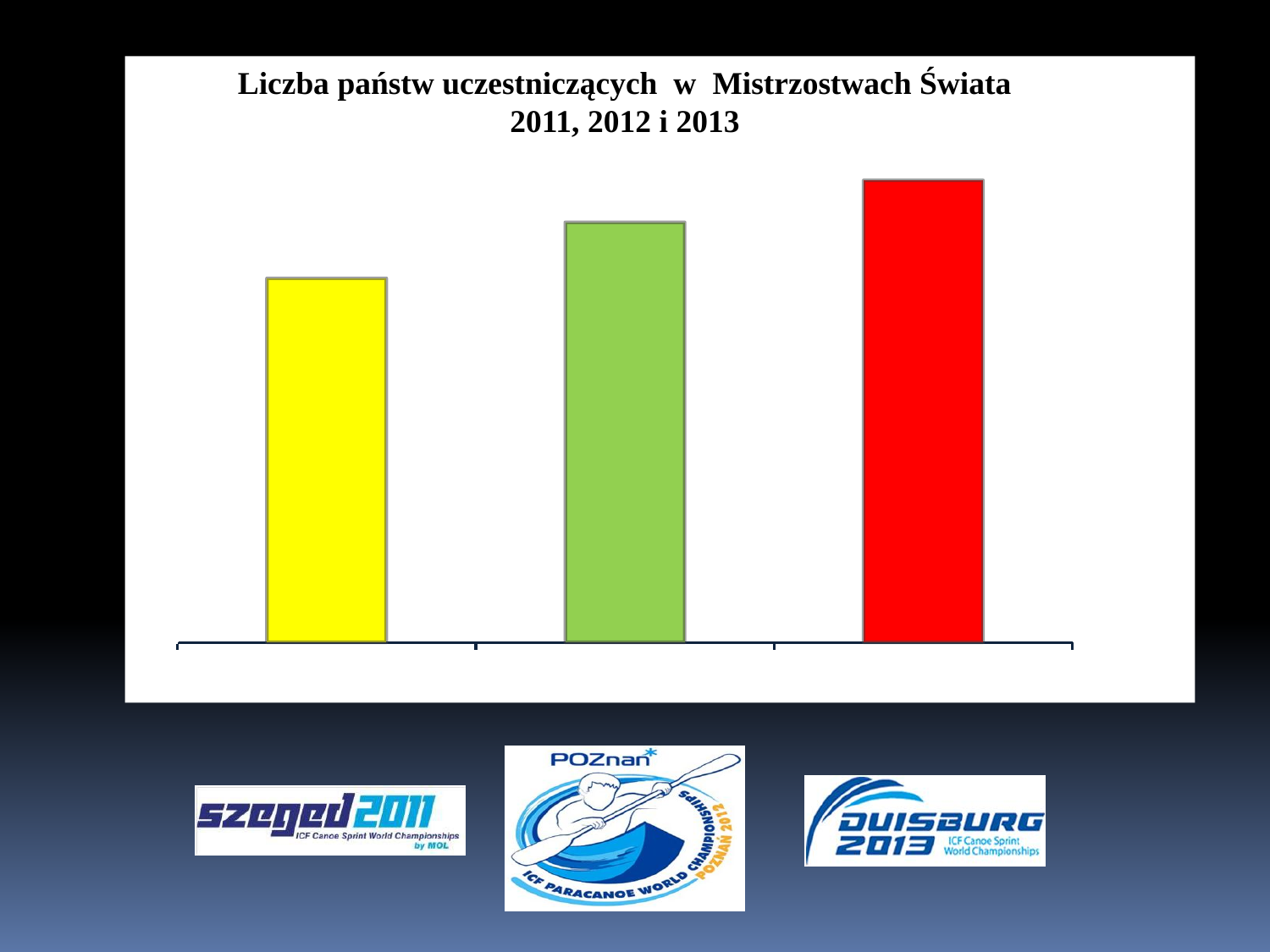
Which position does the tallest bar occupy in the chart: left, middle or right? right What colour is the middle bar in the chart? green Which bar is taller, the red bar or the green bar? red Which bar is taller, the green bar or the yellow bar? green What kind of chart is shown on the slide? bar chart Which bar is the tallest in the chart: the yellow, the green or the red one? red How many bars does the chart contain? 3 Which bar is the shortest in the chart: the yellow, the green or the red one? yellow Do the bar heights rise or fall from left to right across the chart? rise What is the title of the chart? Liczba państw uczestniczących w Mistrzostwach Świata 2011, 2012 i 2013